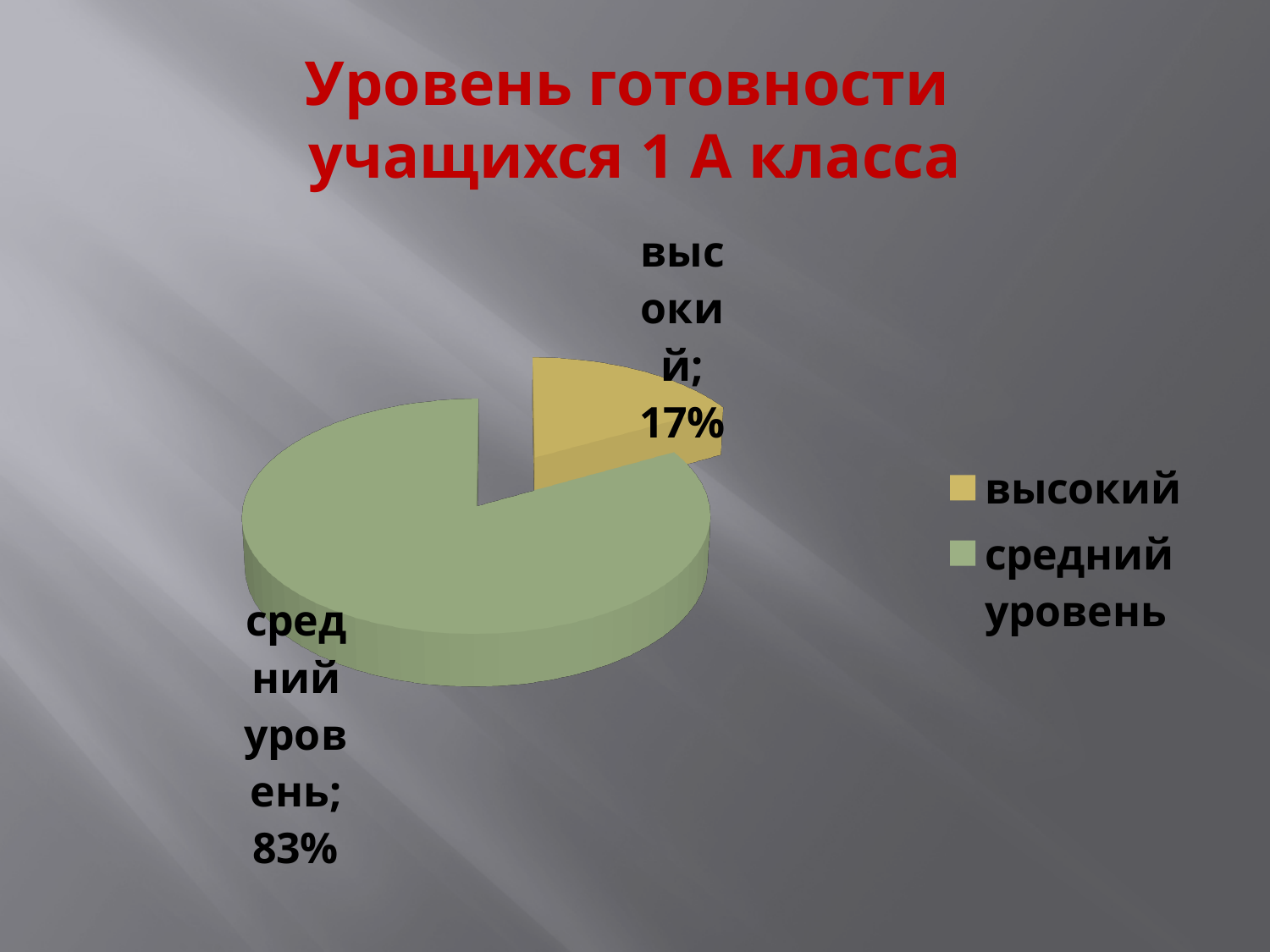
Which is larger, the "высокий" slice or the "средний уровень" slice? средний уровень What kind of chart is shown on the slide? pie chart What is the difference in percentage points between the "средний уровень" and "высокий" slices? 66 How many slices does the pie chart have? 2 Which category has the largest slice of the pie? средний уровень What colour is the "средний уровень" slice? green What is the title of the slide? Уровень готовности учащихся 1 А класса Which category has the smallest slice of the pie? высокий What share of the pie does the "средний уровень" slice represent? 83% How many entries does the legend list? 2 What share of the pie does the "высокий" slice represent? 17%